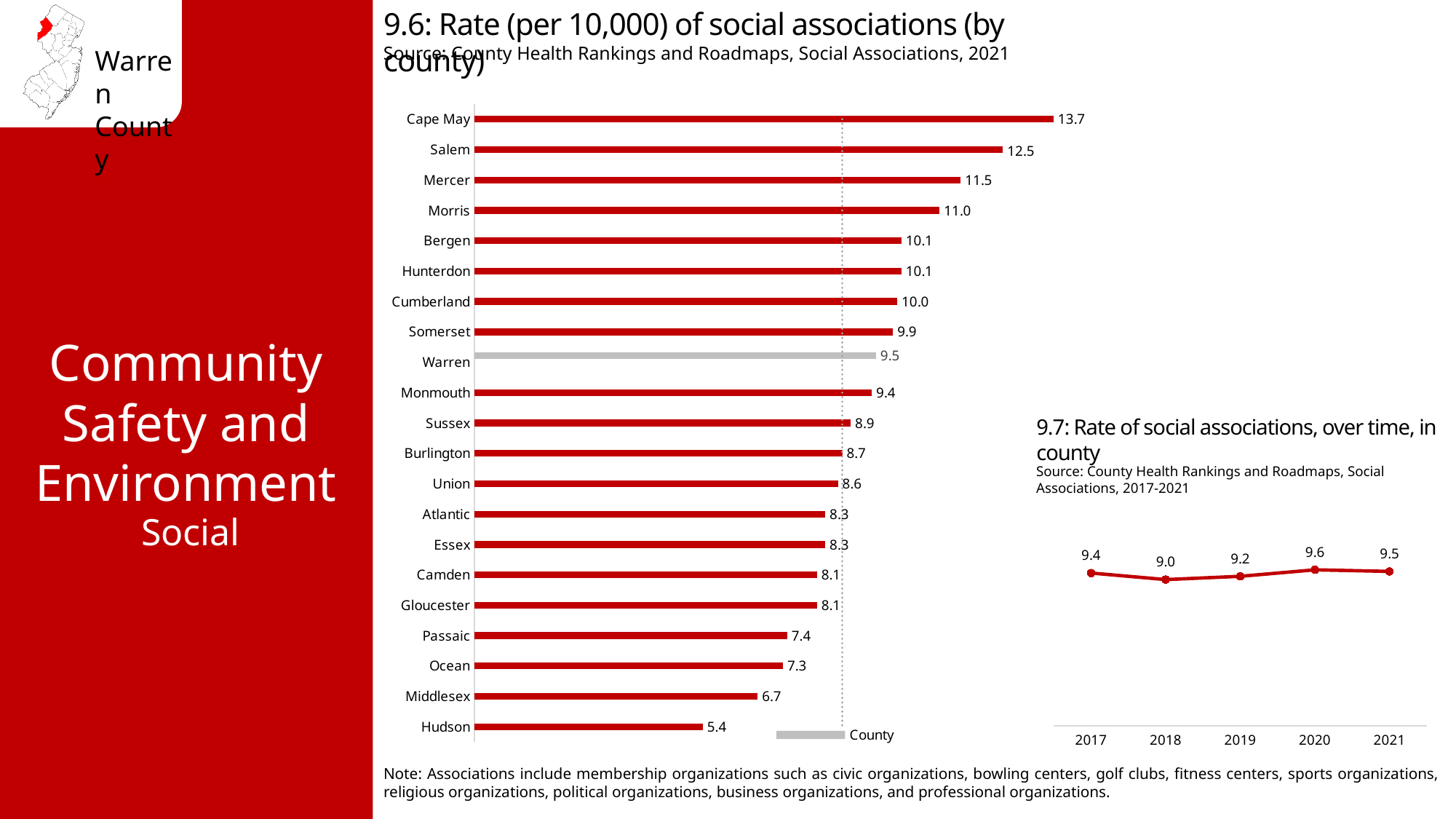
In chart 9.6, which county has the highest rate of social associations? Cape May In chart 9.7, which year had the highest rate of social associations? 2020 In chart 9.7, what was the rate of social associations in 2018? 9.0 In chart 9.7, how many years are plotted? 5 In chart 9.6, which county has the lowest rate of social associations? Hudson In chart 9.6, what is the difference between the rates for Cape May and Hudson? 8.3 In chart 9.6, what label is shown in the legend for the grey bar? County What type of chart is chart 9.6? Bar chart In chart 9.6, what is the rate of social associations for Mercer? 11.5 In chart 9.6, how many counties are shown? 21 In chart 9.6, which county has a higher rate, Salem or Morris? Salem In chart 9.6, what is the rate of social associations for Warren? 9.5